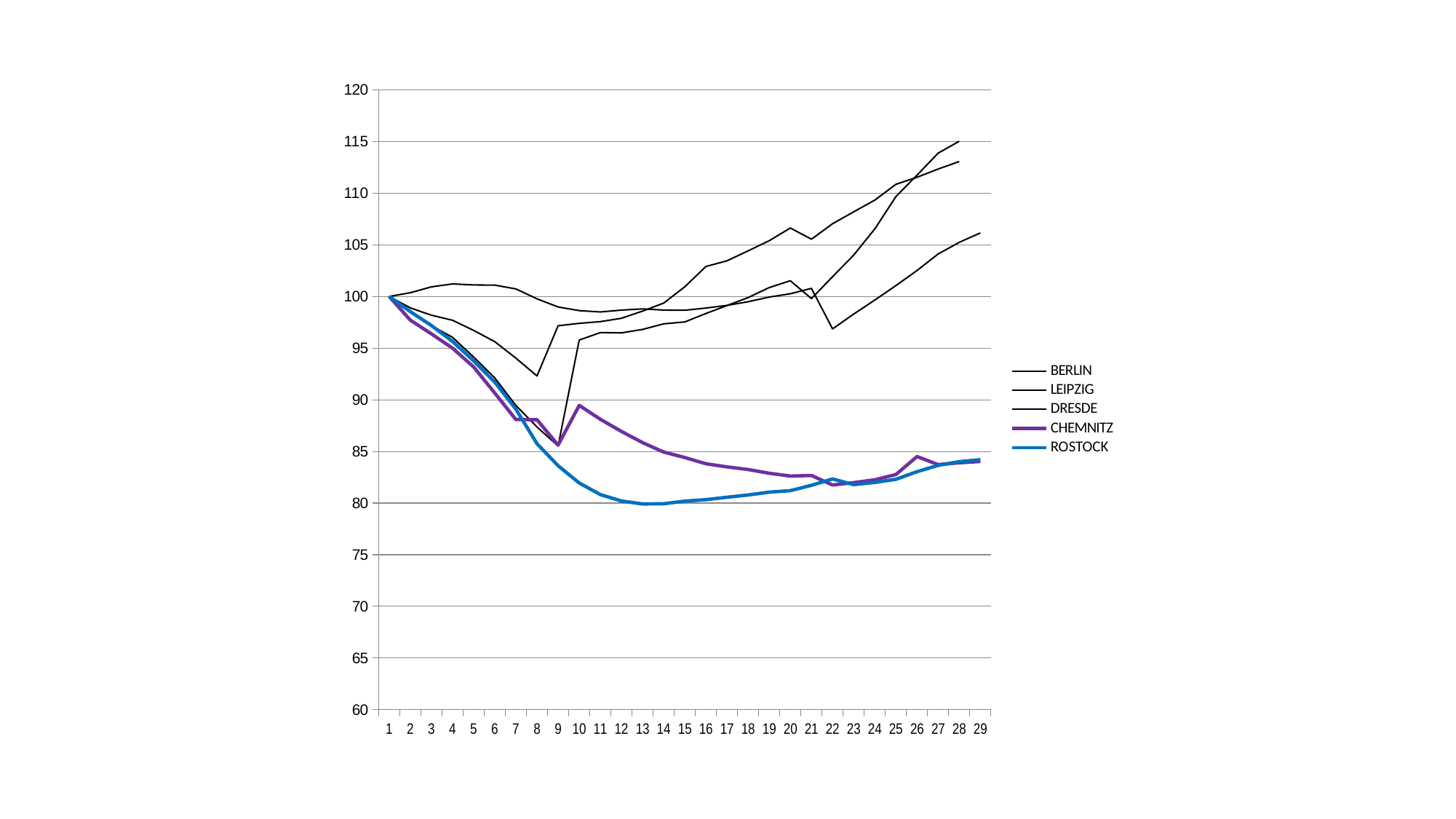
At point 13, which is larger, CHEMNITZ or ROSTOCK? CHEMNITZ How many points are there along the x axis? 29 Does the ROSTOCK line rise or fall from point 1 to point 13? fall Is the value for ROSTOCK at point 29 greater or less than 80? greater Which series has the lowest value at point 13? ROSTOCK What is the value of ROSTOCK at point 1? 100 What colour is the ROSTOCK line? blue What is the value of CHEMNITZ at point 1? 100 Is the value for ROSTOCK at point 13 greater or less than 85? less How many series does the legend list? 5 What kind of chart is shown on the slide? line chart Is the value for CHEMNITZ at point 10 greater or less than 85? greater